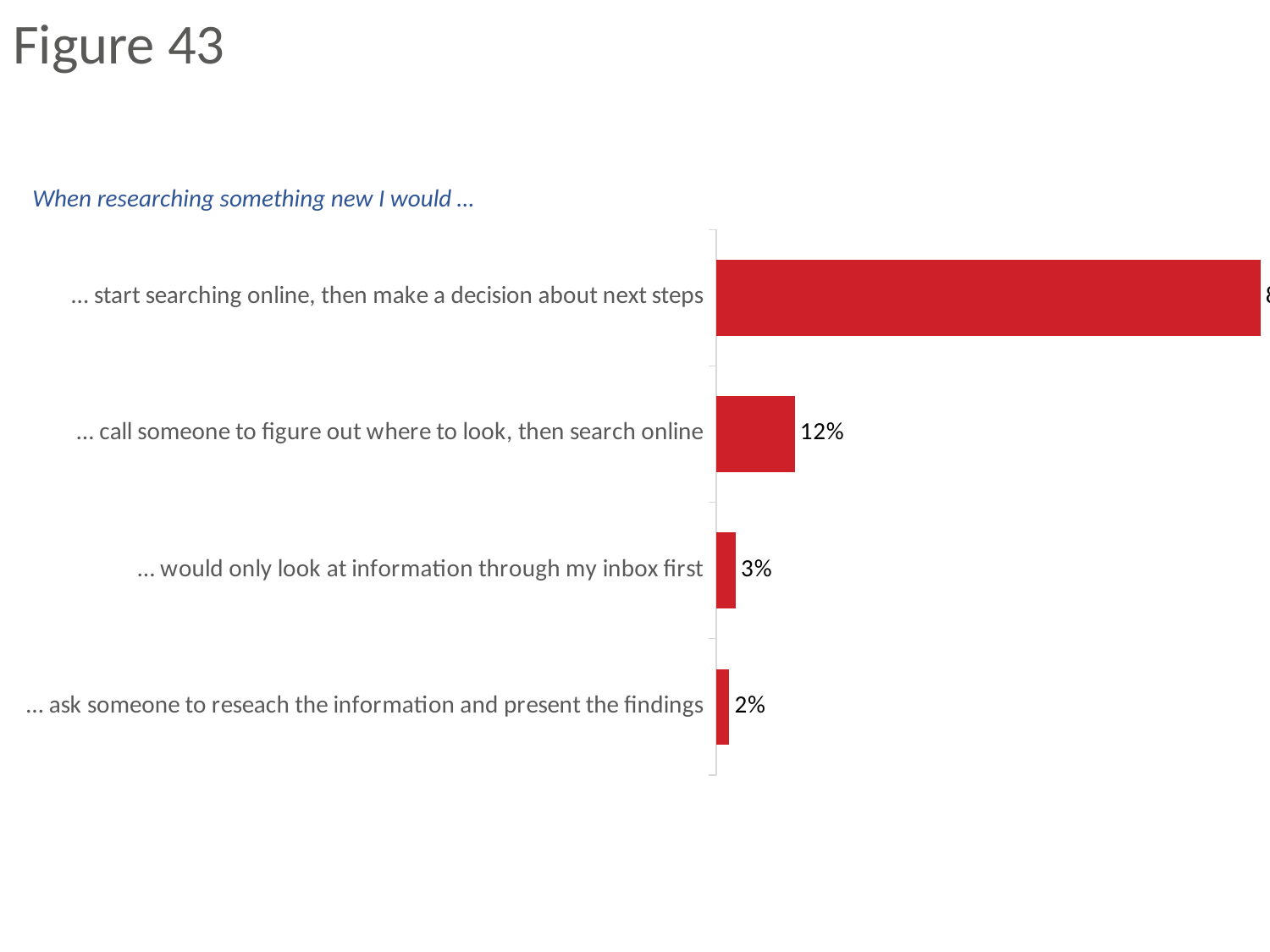
What is the statement stem shown above the chart? When researching something new I would ... What is the difference between the value for "would only look at information through my inbox first" and "ask someone to reseach the information and present the findings"? 1% How many response categories are shown in the chart? 4 Which is larger: the value for "call someone to figure out where to look, then search online" or "would only look at information through my inbox first"? ... call someone to figure out where to look, then search online What is the value for "ask someone to reseach the information and present the findings"? 2% Which response has the highest value? ... start searching online, then make a decision about next steps What is the difference between the value for "call someone to figure out where to look, then search online" and "would only look at information through my inbox first"? 9% What colour are the bars in the chart? Red What kind of chart is shown on the slide? Bar chart What is the value for "would only look at information through my inbox first"? 3% What percentage of respondents would call someone to figure out where to look, then search online? 12% Which response has the lowest value? ... ask someone to reseach the information and present the findings